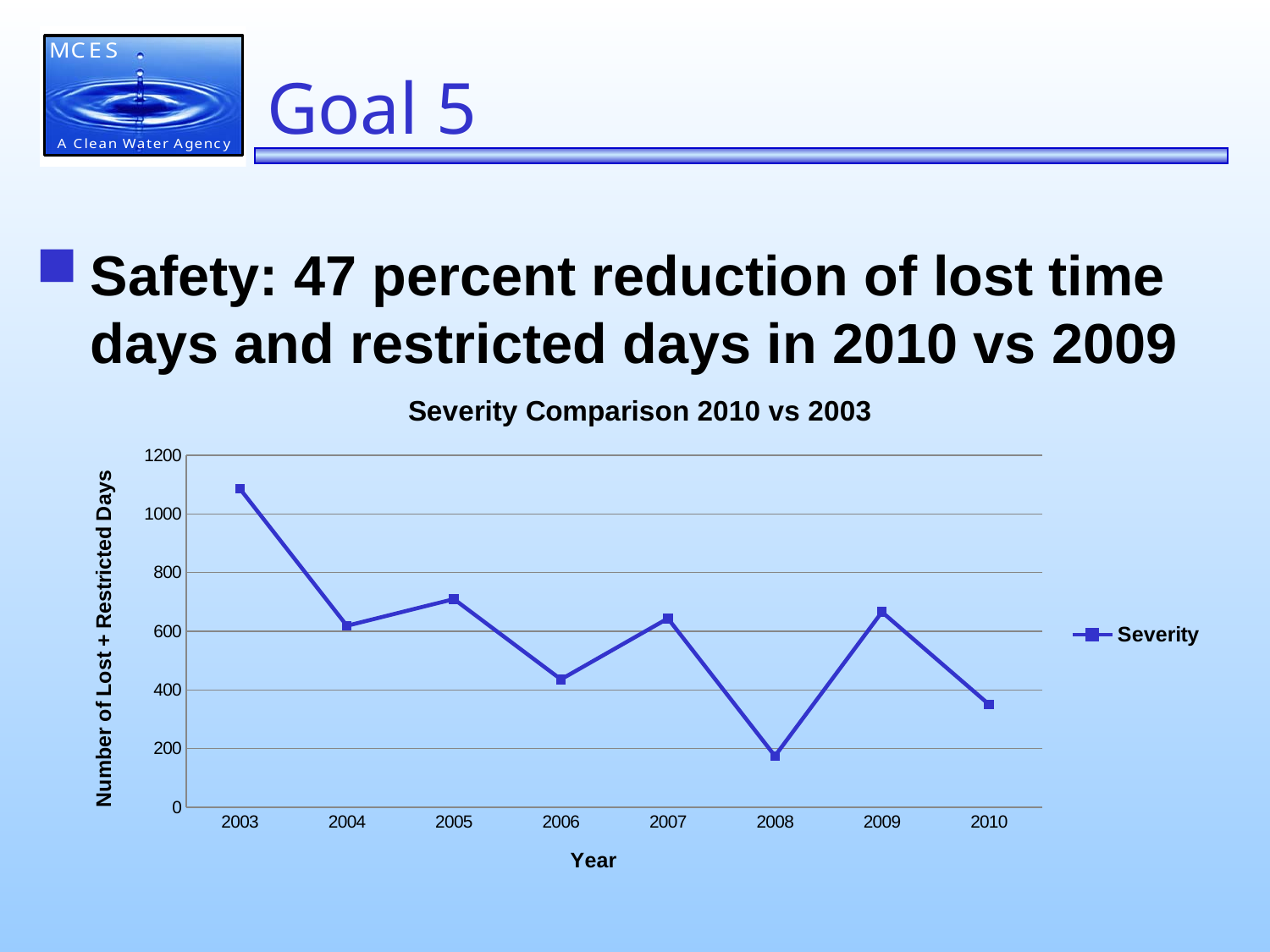
How many years are plotted on the x axis? 8 Which year has the highest Severity value? 2003 Which year has a larger Severity value, 2005 or 2006? 2005 Which year has the lowest Severity value? 2008 What kind of chart is shown on the slide? Line chart Which year has a larger Severity value, 2008 or 2009? 2009 What is the title of the chart? Severity Comparison 2010 vs 2003 Overall, does the Severity value rise or fall from 2003 to 2010? Fall Is the Severity value for 2010 greater or less than 400? less How many series does the legend list? 1 Is the Severity value for 2008 greater or less than 200? less Is the Severity value for 2003 greater or less than 1000? greater